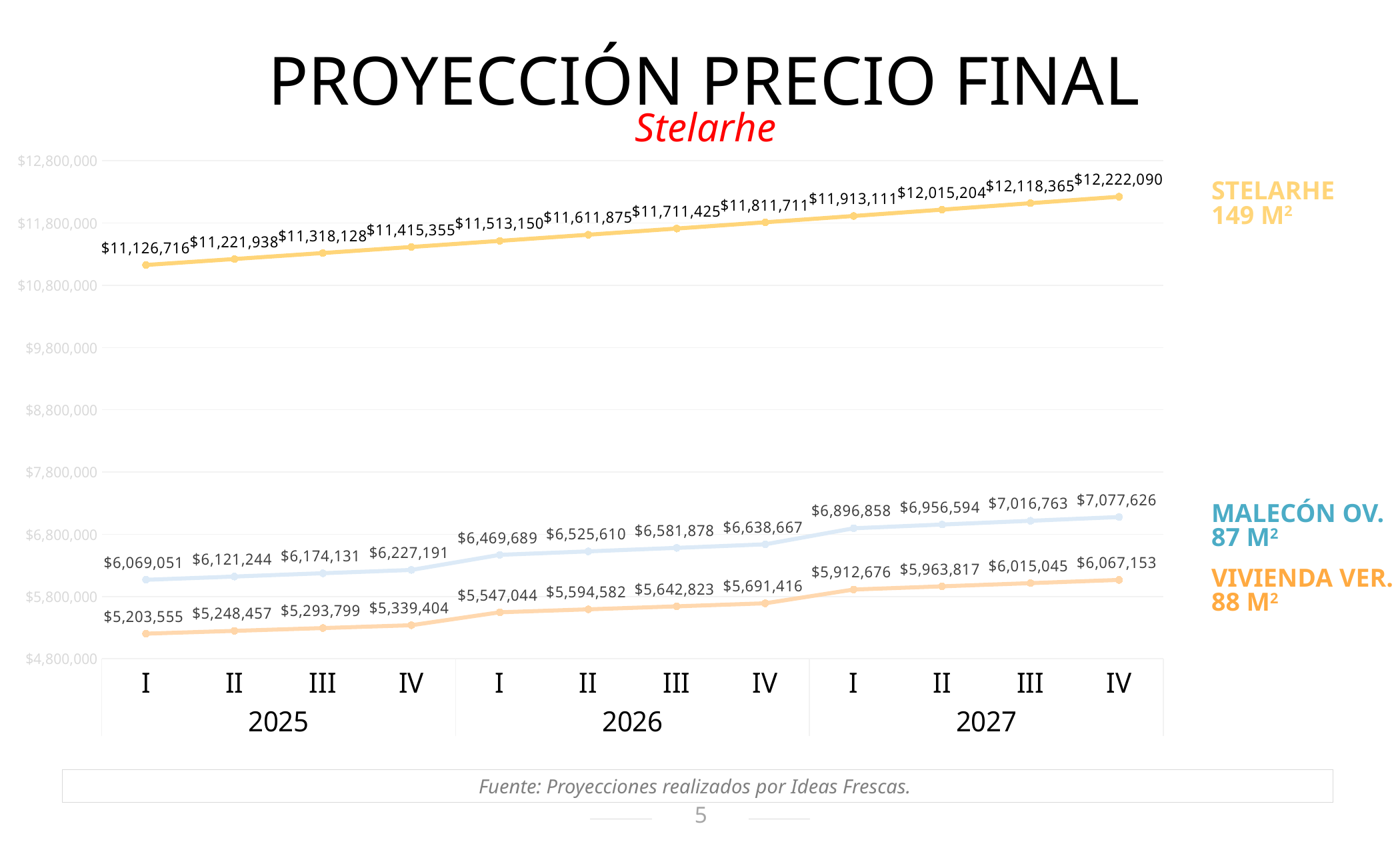
Do the projected prices rise or fall from 2025 to 2027? Rise How many quarterly data points does each series have? 12 What is the projected price for STELARHE 149 M² in quarter IV of 2027? $12,222,090 What is the projected price for VIVIENDA VER. 88 M² in quarter I of 2026? $5,547,044 In quarter IV of 2027, which is larger: the MALECÓN OV. 87 M² price or the VIVIENDA VER. 88 M² price? MALECÓN OV. 87 M² What is the difference between the STELARHE 149 M² price in quarter IV of 2027 and in quarter I of 2025? $1,095,374 Which series has the highest projected prices across the chart? STELARHE 149 M² Which series has the lowest projected prices across the chart? VIVIENDA VER. 88 M² What is the projected price for MALECÓN OV. 87 M² in quarter IV of 2027? $7,077,626 What is the projected price for STELARHE 149 M² in quarter I of 2025? $11,126,716 What kind of chart is shown on the slide? Line chart How many series are plotted on the chart? 3